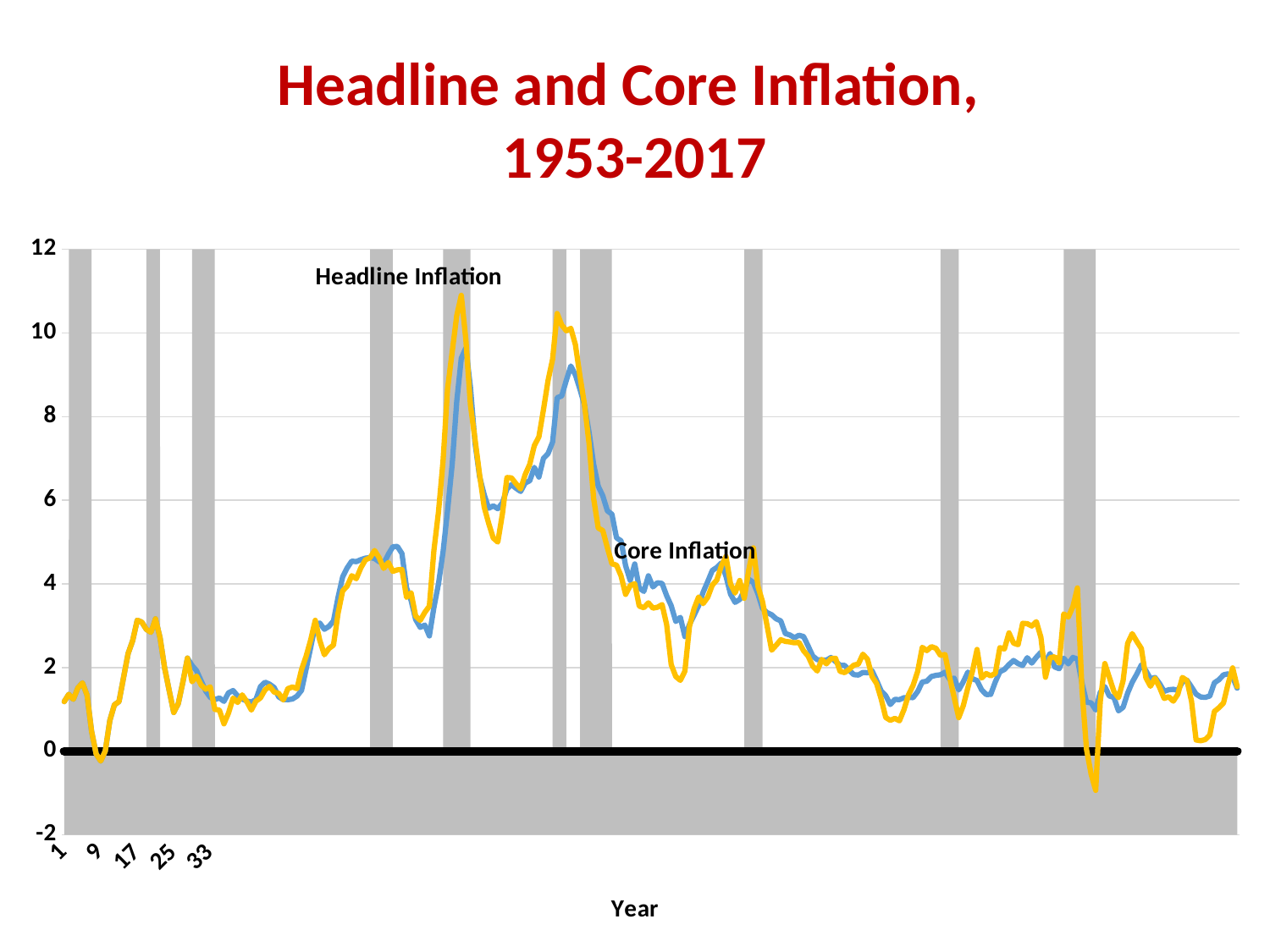
Is the highest value reached by Headline Inflation greater or less than 10? greater Which series reaches the higher peak, Headline Inflation or Core Inflation? Headline Inflation Is the highest value reached by Core Inflation greater or less than 8? greater What is the title of the chart? Headline and Core Inflation, 1953-2017 After its highest peak, does Headline Inflation generally rise or fall toward the right end of the chart? fall Is the lowest value of Headline Inflation greater or less than 0? less Which colour is the Headline Inflation line drawn in? Yellow What kind of chart is shown on the slide? Line chart How many data series are plotted on the chart? 2